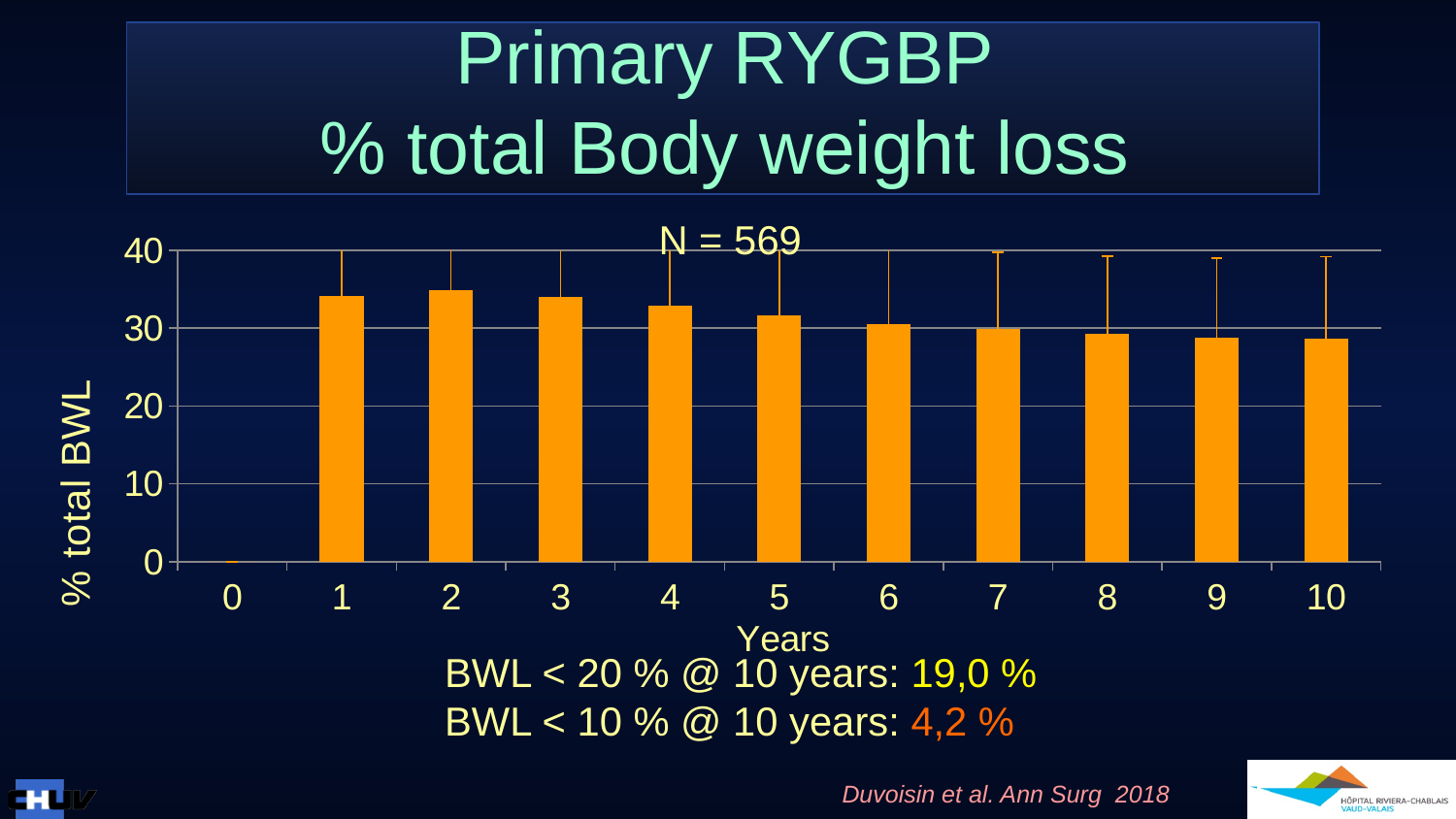
Is the value for year 10 greater or less than 20? greater Which year has the lowest % total BWL? 0 Is the value for year 1 greater or less than 30? greater Which has the larger % total BWL, year 1 or year 10? year 1 How many year categories are shown on the x axis of the chart? 11 Is the value for year 10 greater or less than 30? less What is the sample size N stated above the chart? N = 569 What kind of chart is shown on the slide? bar chart What is the label of the y axis? % total BWL Which has the larger % total BWL, year 3 or year 9? year 3 Do the bar values rise or fall from year 1 to year 10? fall